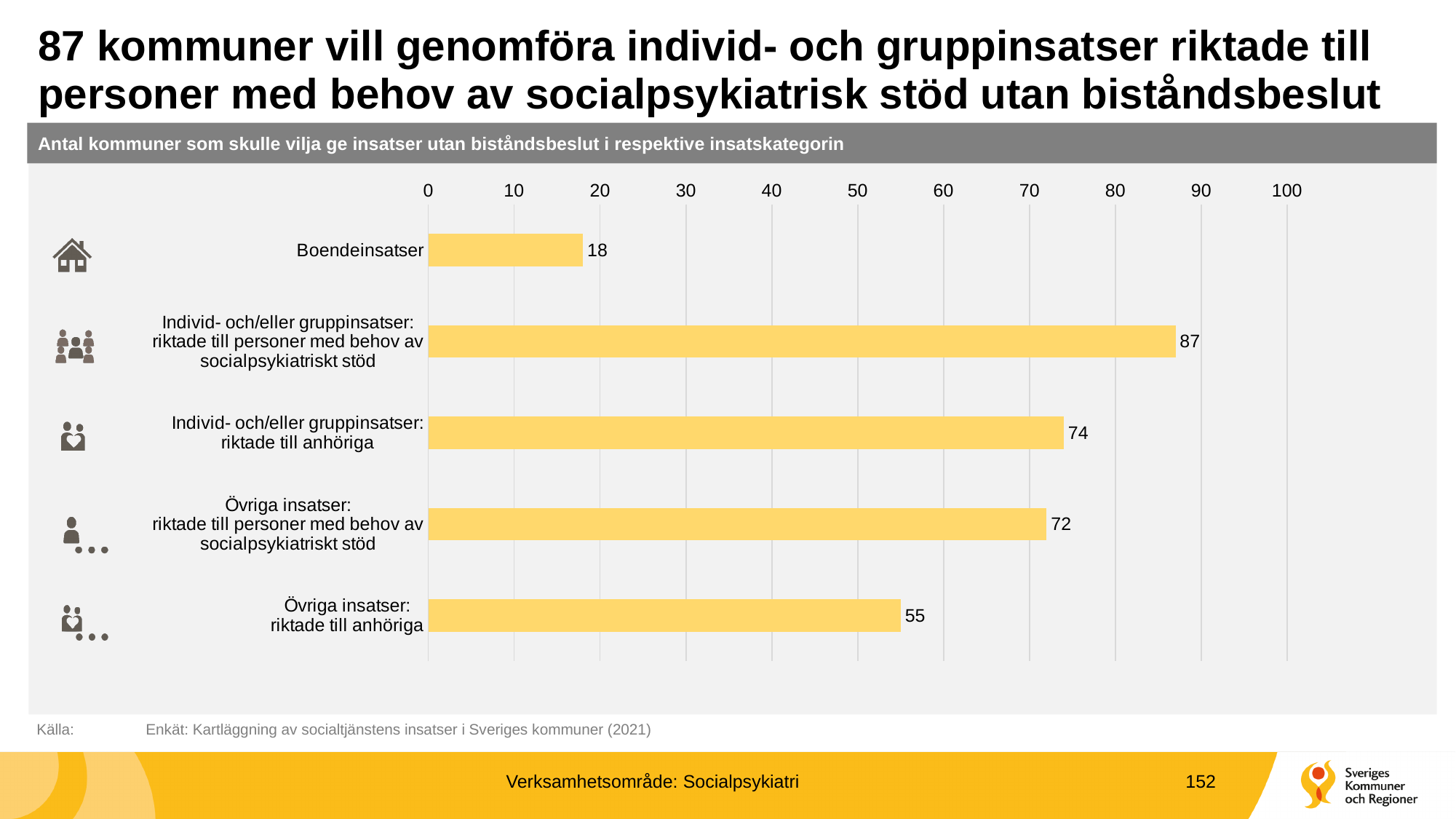
What is the value for Övriga insatser: riktade till anhöriga? 55 What is the value for Boendeinsatser? 18 Is the value for Övriga insatser: riktade till anhöriga greater or less than 60? less Which is larger: the value for Övriga insatser: riktade till personer med behov av socialpsykiatriskt stöd or the value for Övriga insatser: riktade till anhöriga? Övriga insatser: riktade till personer med behov av socialpsykiatriskt stöd What is the title of the chart? Antal kommuner som skulle vilja ge insatser utan biståndsbeslut i respektive insatskategorin Which category has the highest value? Individ- och/eller gruppinsatser: riktade till personer med behov av socialpsykiatriskt stöd What is the difference between the values for Individ- och/eller gruppinsatser: riktade till anhöriga and Övriga insatser: riktade till anhöriga? 19 What kind of chart is shown on the slide? bar chart How many categories are shown in the chart? 5 Which category has the lowest value? Boendeinsatser What is the difference between the values for Individ- och/eller gruppinsatser: riktade till personer med behov av socialpsykiatriskt stöd and Boendeinsatser? 69 What is the value for Individ- och/eller gruppinsatser: riktade till anhöriga? 74